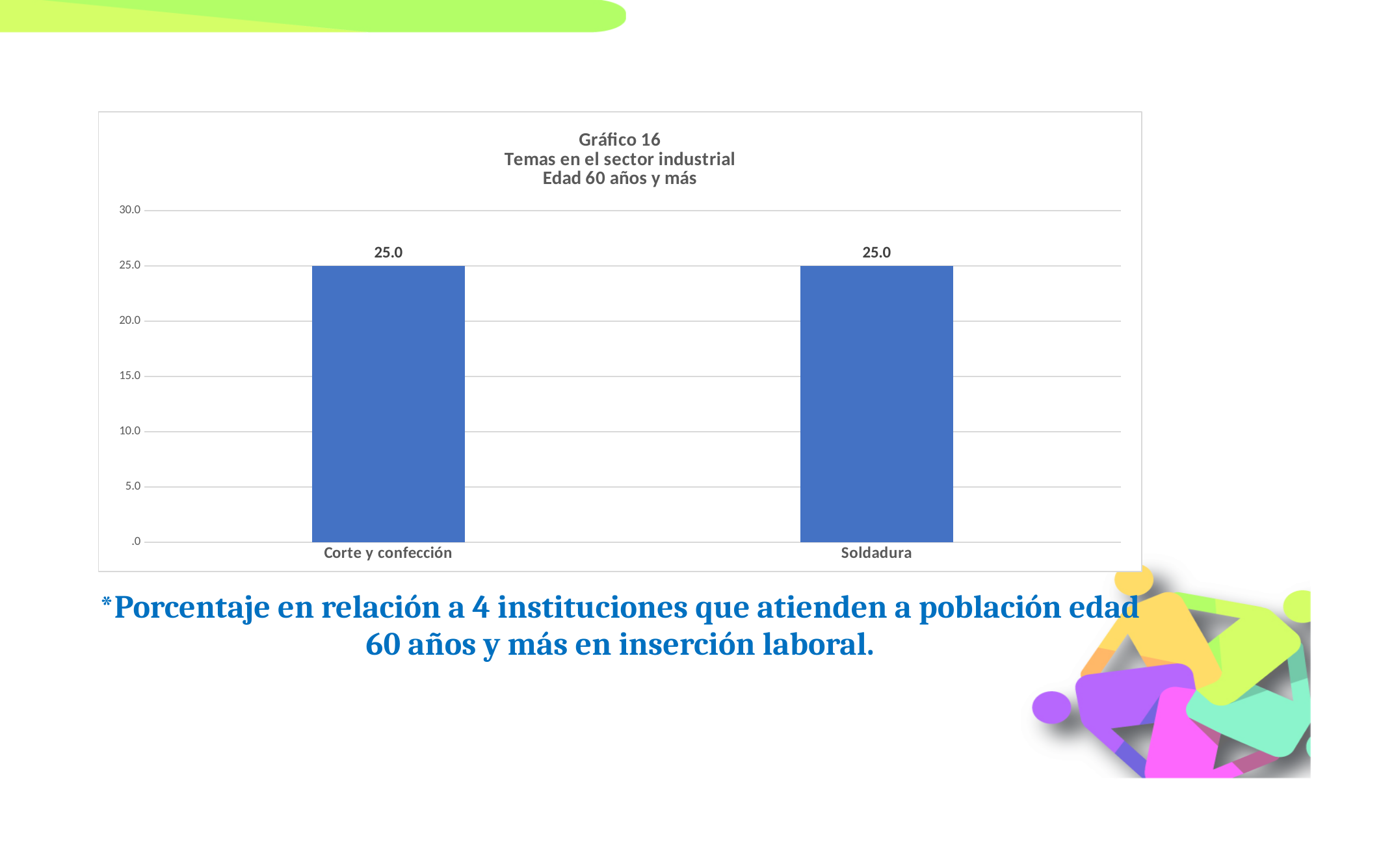
What is the difference between the values for Corte y confección and Soldadura? 0.0 What is the highest value shown on the y axis? 30.0 What is the total of the two values shown in the chart? 50.0 What kind of chart is shown on the slide? bar chart What is the value for Corte y confección? 25.0 What is the chart number given in the title? Gráfico 16 How many categories are shown on the x axis? 2 Is the value for Corte y confección greater or less than 30.0? less Is the value for Soldadura greater or less than 20.0? greater What is the value for Soldadura? 25.0 Do the values rise, fall or stay the same from Corte y confección to Soldadura? stay the same